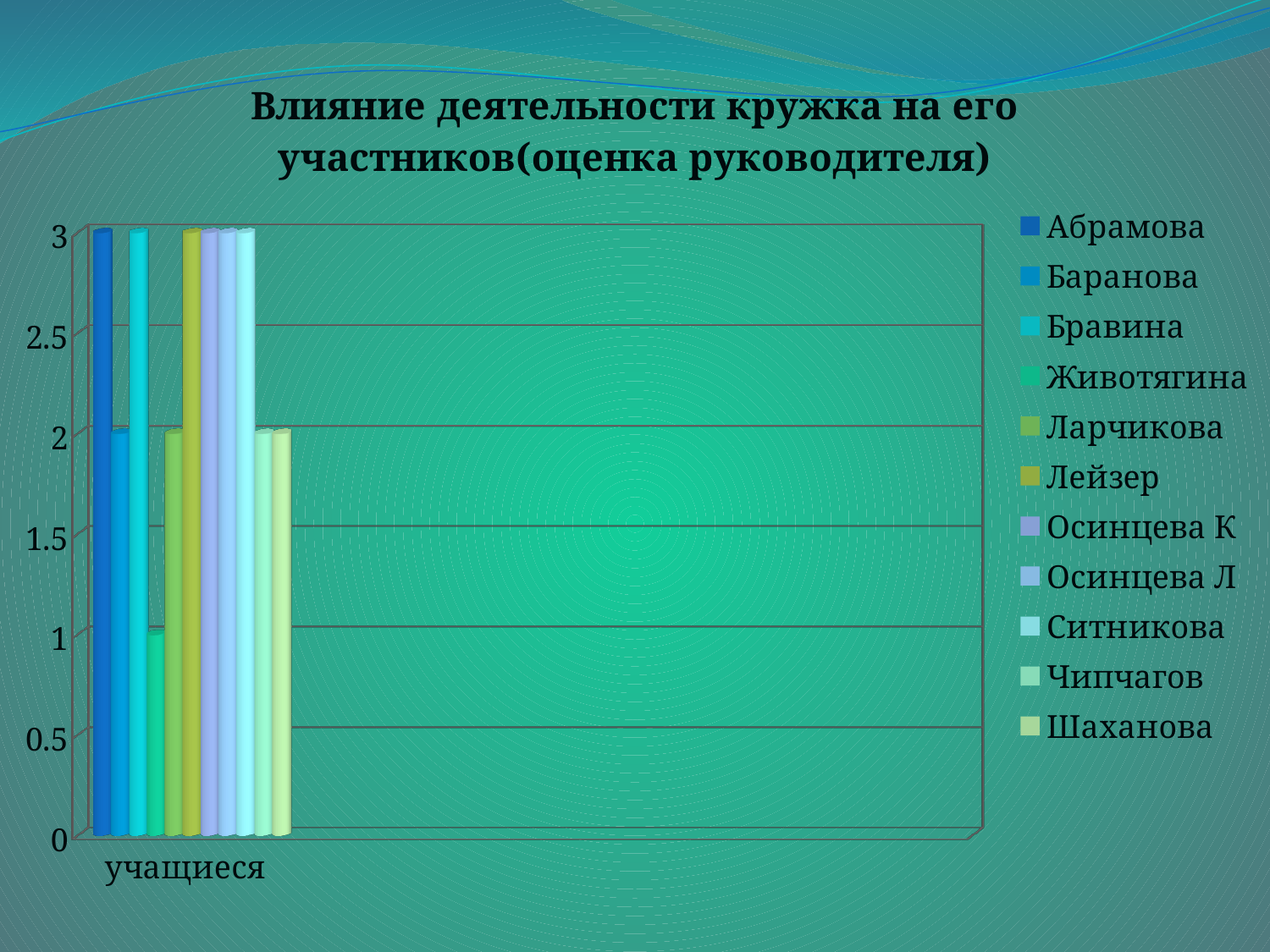
What is the value for Шаханова? 2 How many series does the legend list? 11 How many categories are shown on the x axis? 1 What is the difference between the values for Абрамова and Животягина? 2 What is the value for Баранова? 2 What is the value for Животягина? 1 Which is larger, the value for Лейзер or the value for Ларчикова? Лейзер What kind of chart is shown on the slide? bar chart What is the label of the category on the x axis? учащиеся What is the value for Абрамова? 3 Is the value for Чипчагов greater or less than 2.5? less Which series has the lowest value? Животягина